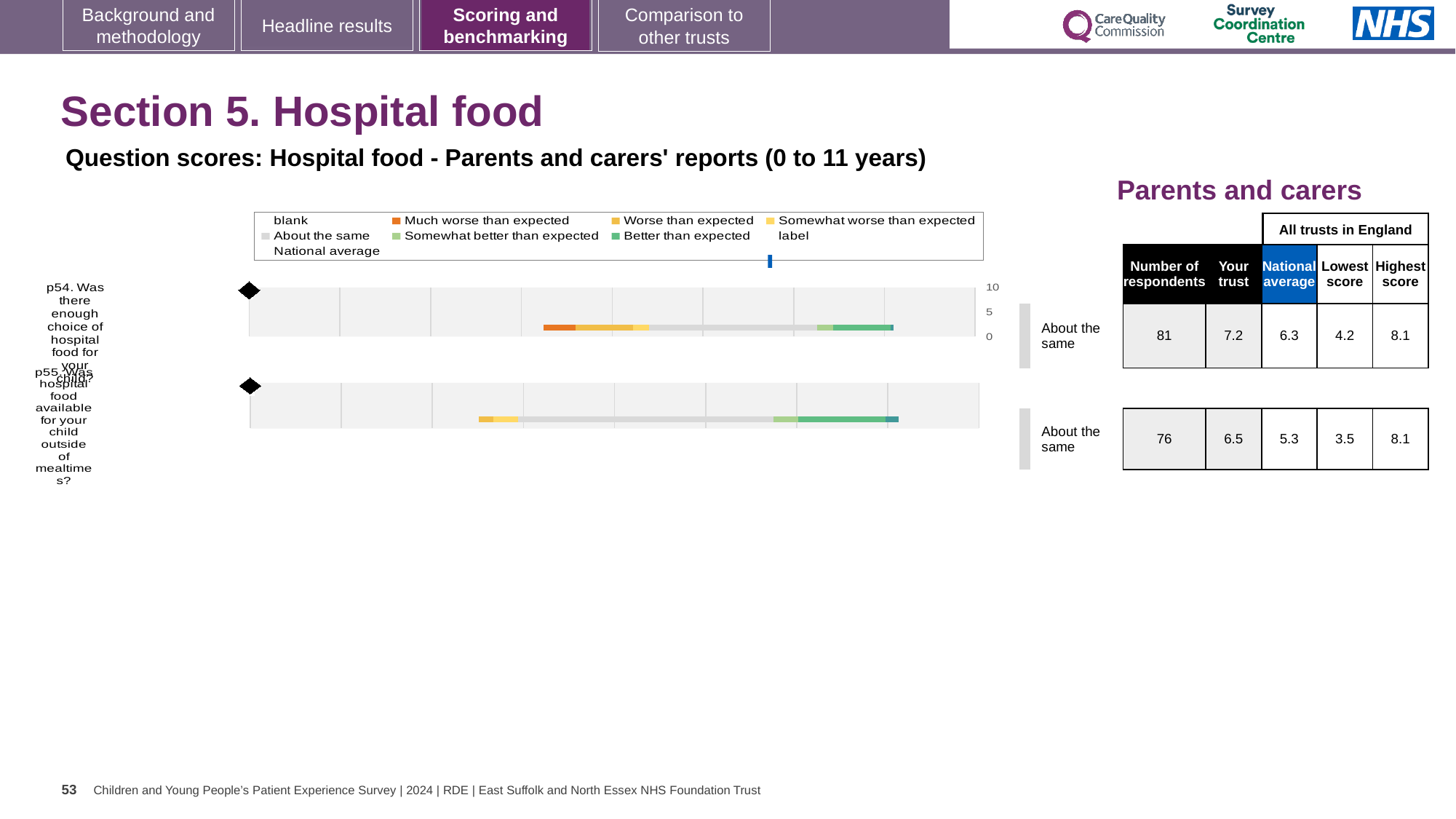
What colour represents 'Better than expected' in the chart legend? green What colour represents 'Much worse than expected' in the chart legend? orange How many respondents answered p55? 76 What benchmark category is shown for p54? About the same What is the 'Your trust' score for p54 (enough choice of hospital food for your child)? 7.2 How many entries does the chart legend list? 9 What kind of chart is shown on the slide? bar chart What is the lowest score among all trusts in England for p55? 3.5 What is the difference between the 'Your trust' score and the national average for p54? 0.9 Which question has the higher 'Your trust' score, p54 or p55? p54 How many questions (categories) are plotted in the chart? 2 What is the national average score for p55 (hospital food available outside of mealtimes)? 5.3